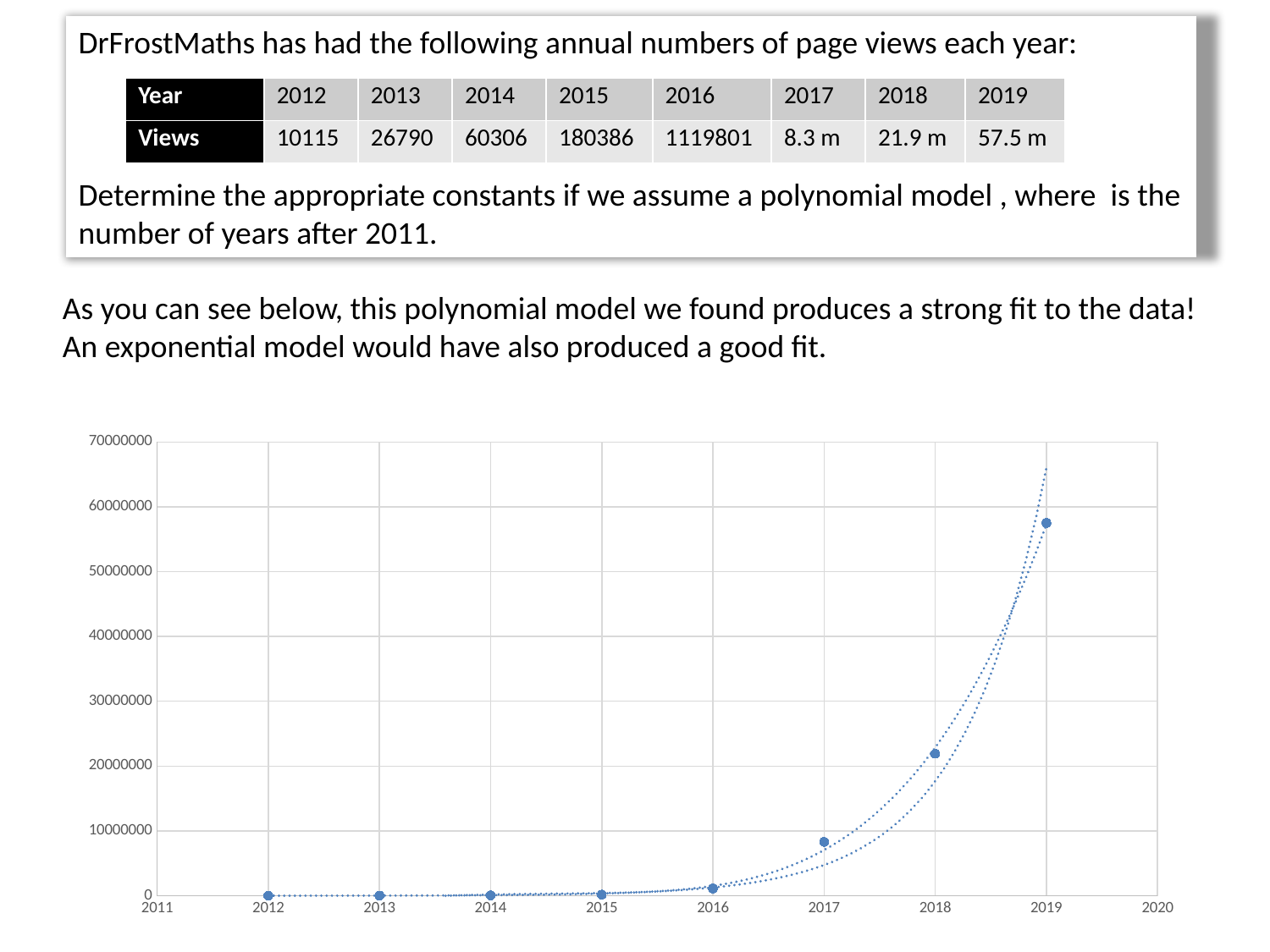
What kind of chart is shown on the slide? scatter chart How many data points are plotted on the chart? 8 What is the highest value shown on the vertical axis of the chart? 70000000 Which year has the larger number of page views, 2018 or 2017? 2018 Is the plotted value for 2017 greater or less than 10000000? less Is the plotted value for 2019 greater or less than 50000000? greater Which year has the highest plotted number of page views? 2019 How many dotted trend curves are drawn on the chart? 2 Is the plotted value for 2018 greater or less than 20000000? greater Which year has the lowest number of page views? 2012 Do the page views rise or fall from 2012 to 2019? rise